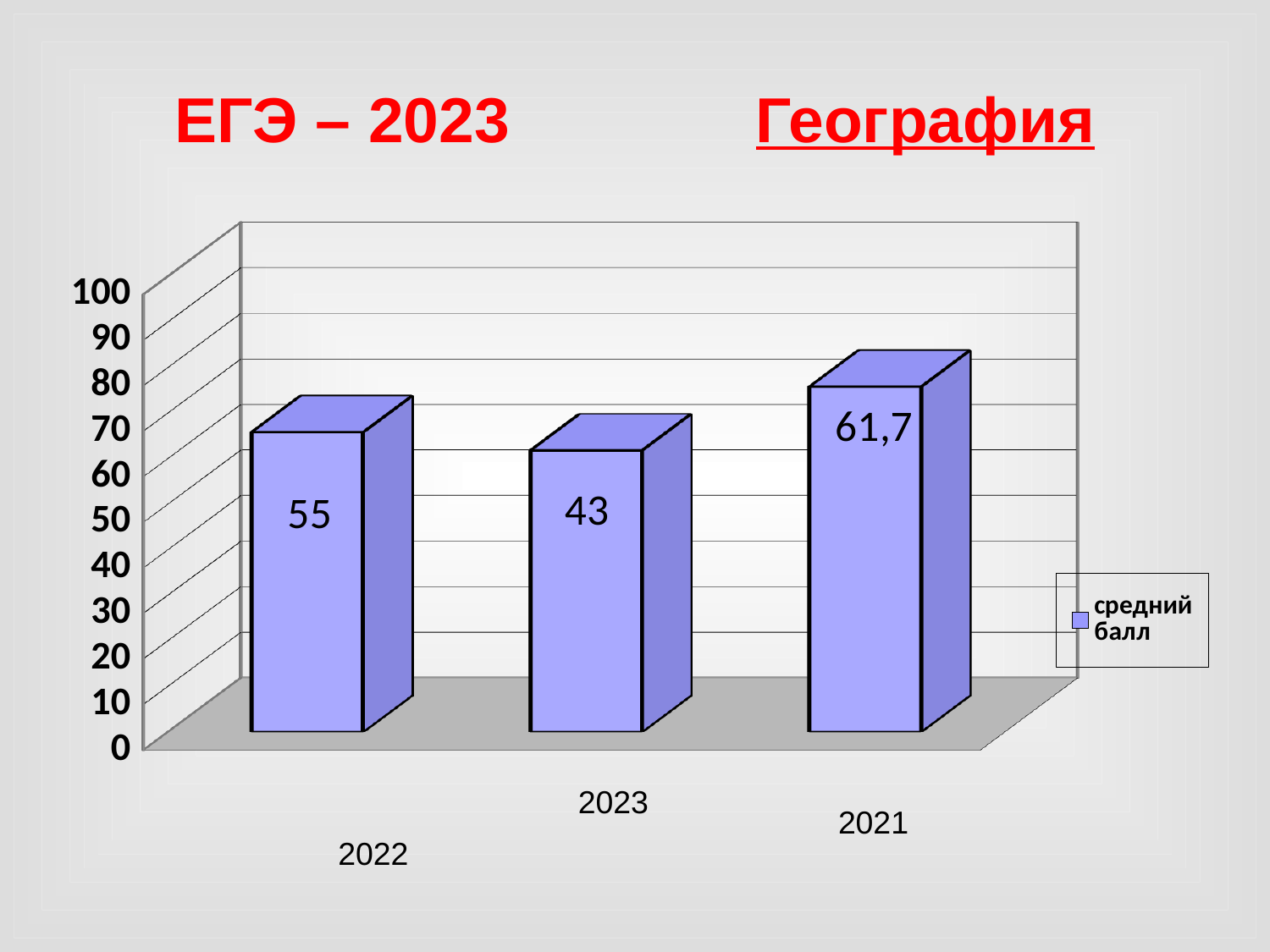
What is the name of the series shown in the legend? средний балл How many series does the legend list? 1 How many years (bars) are shown in the chart? 3 Which year has the lowest average score? 2023 Is the value for 2021 greater or less than 60? greater What is the difference between the average scores for 2022 and 2023? 12 What is the average score (средний балл) for 2022? 55 What is the average score (средний балл) for 2021? 61,7 Which is larger, the average score for 2022 or for 2023? 2022 Which year has the highest average score? 2021 What is the average score (средний балл) for 2023? 43 What kind of chart is shown on the slide? bar chart